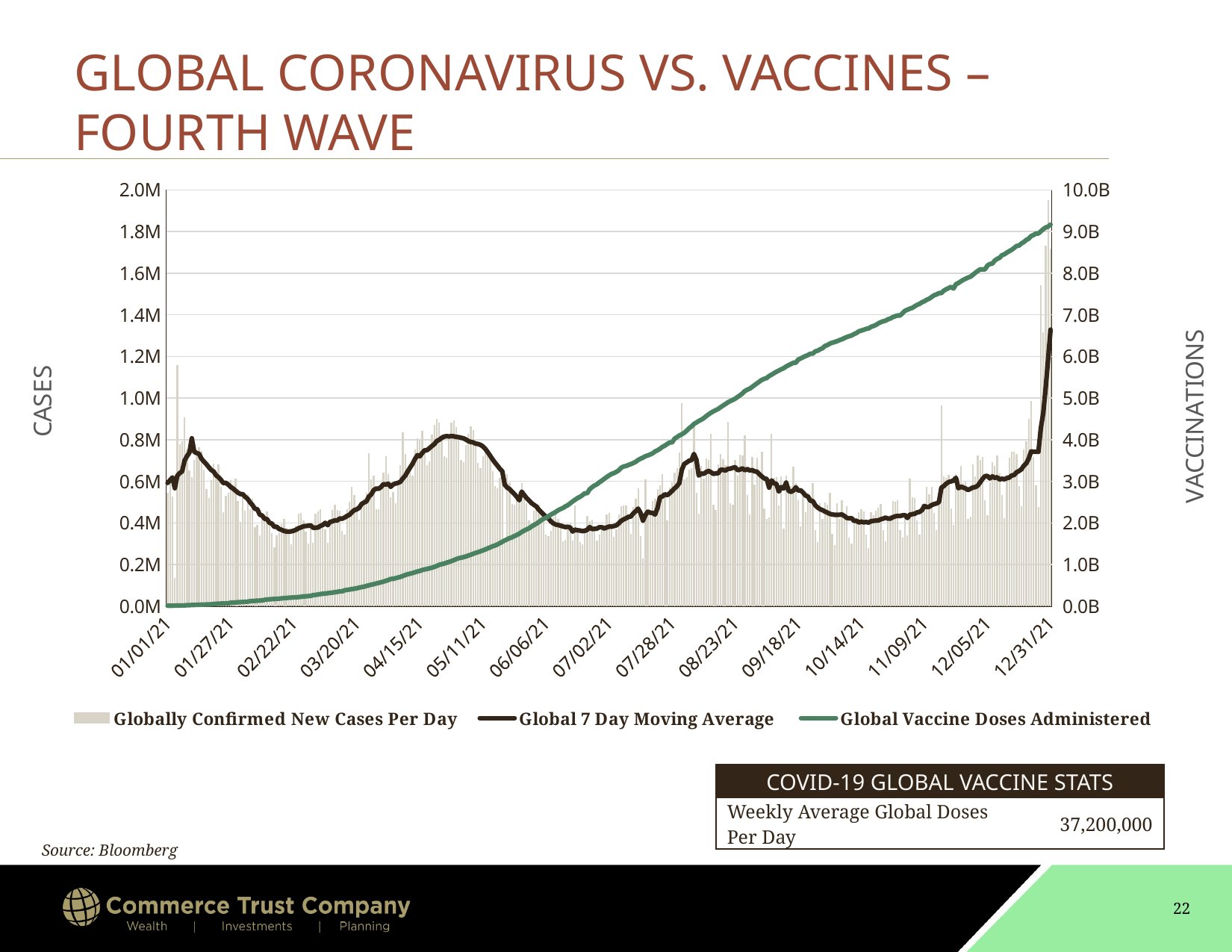
Is the Global 7 Day Moving Average at 12/31/21 greater or less than 1.0M? greater How many date labels are shown on the x axis? 15 What kind of chart is shown on the slide? A combined bar and line chart What is the highest value shown on the right (VACCINATIONS) axis? 10.0B Is the value of Global Vaccine Doses Administered at 12/31/21 greater or less than 8.0B? greater What is the label of the right vertical axis? VACCINATIONS Is the value of Global Vaccine Doses Administered at 07/02/21 greater or less than 4.0B? less What is the label of the left vertical axis? CASES Does the Global Vaccine Doses Administered line rise or fall from 01/01/21 to 12/31/21? Rises How many series does the chart legend list? 3